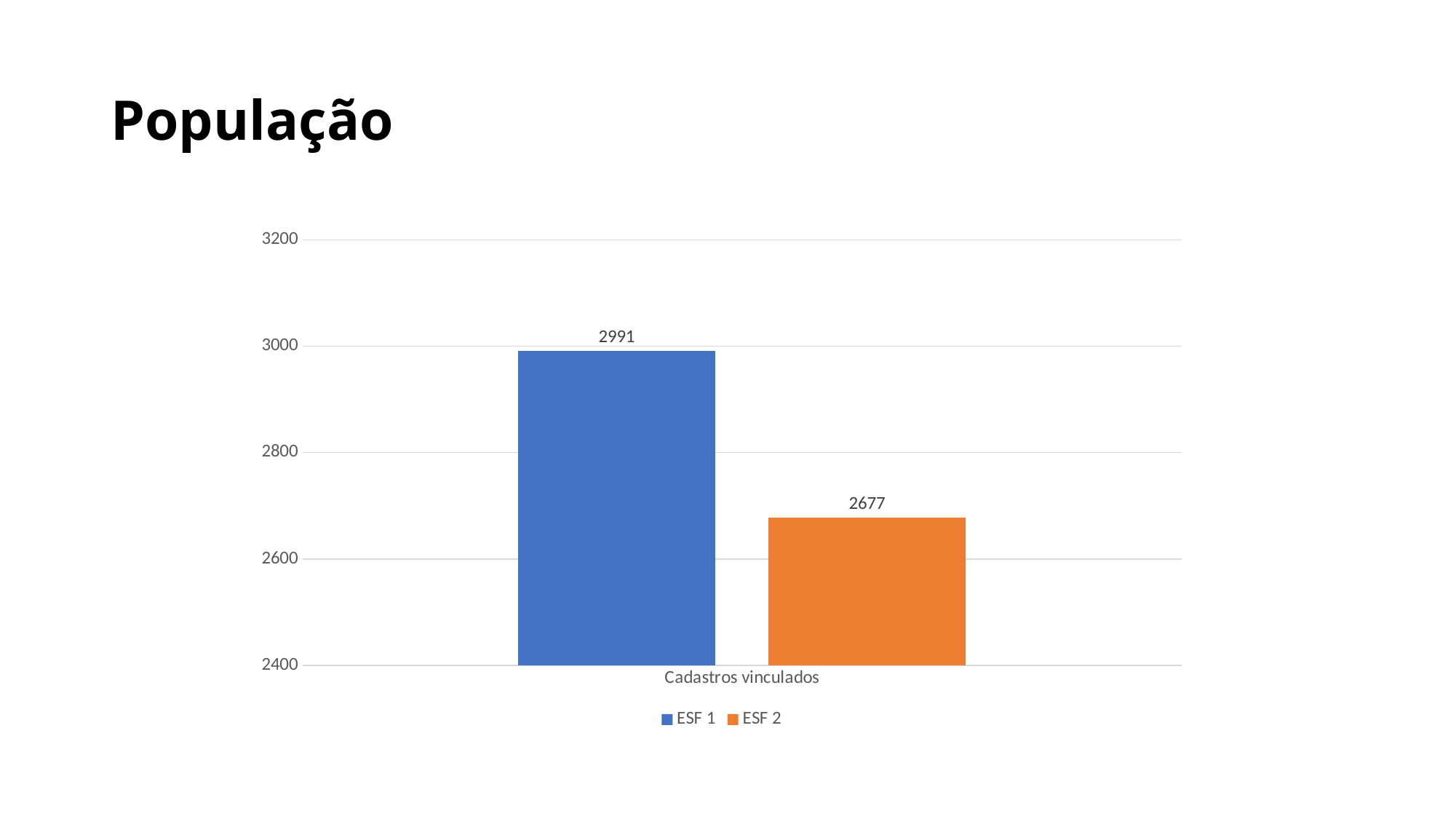
Which is larger, the value for ESF 1 or the value for ESF 2? ESF 1 What colour is the bar for ESF 2? orange Which series has the lowest value in the chart? ESF 2 Is the value for ESF 1 greater or less than 2800? greater What is the category label shown on the x axis of the chart? Cadastros vinculados How many series does the legend list? 2 What is the difference between the values for ESF 1 and ESF 2? 314 What kind of chart is shown on the slide? bar chart What is the value for ESF 1 in the Cadastros vinculados chart? 2991 Is the value for ESF 2 greater or less than 2800? less Which series has the highest value in the chart? ESF 1 What is the value for ESF 2 in the Cadastros vinculados chart? 2677